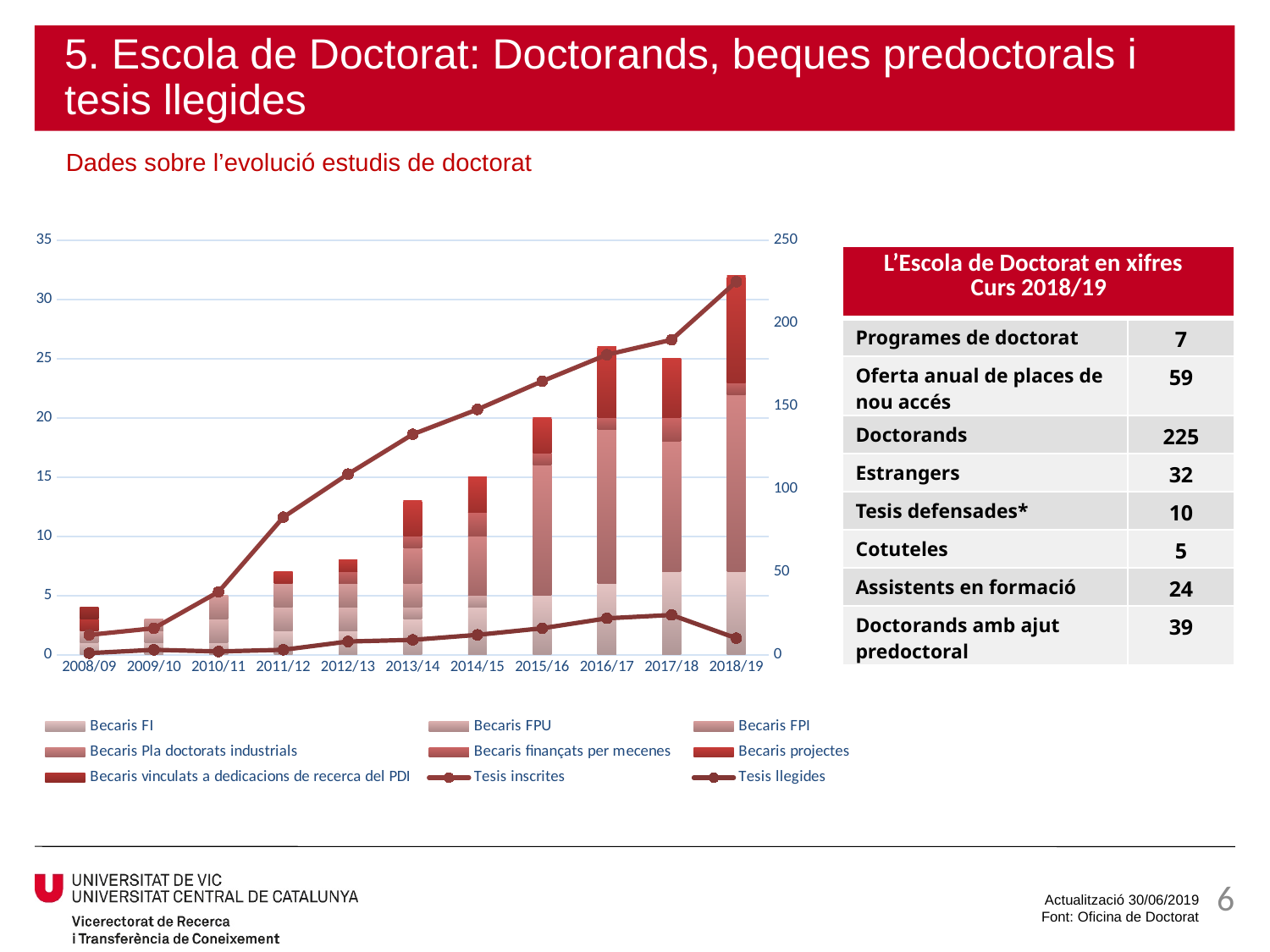
How many series does the chart legend list? 9 Does the Tesis inscrites line rise or fall from 2008/09 to 2018/19? Rises How many academic years are shown on the x axis of the chart? 11 Is the total height of the stacked bar for 2013/14 greater or less than 10 on the left axis? greater Is the value of Tesis inscrites in 2008/09 greater or less than 50 on the right axis? less Is the value of Tesis inscrites in 2018/19 greater or less than 200 on the right axis? greater Which stacked bar is taller, 2017/18 or 2018/19? 2018/19 Does the Tesis llegides line rise or fall between 2017/18 and 2018/19? Falls What kind of chart is shown on the slide? A combined stacked bar and line chart Which two series in the legend are plotted as lines rather than bars? Tesis inscrites and Tesis llegides Which academic year has the tallest stacked bar? 2018/19